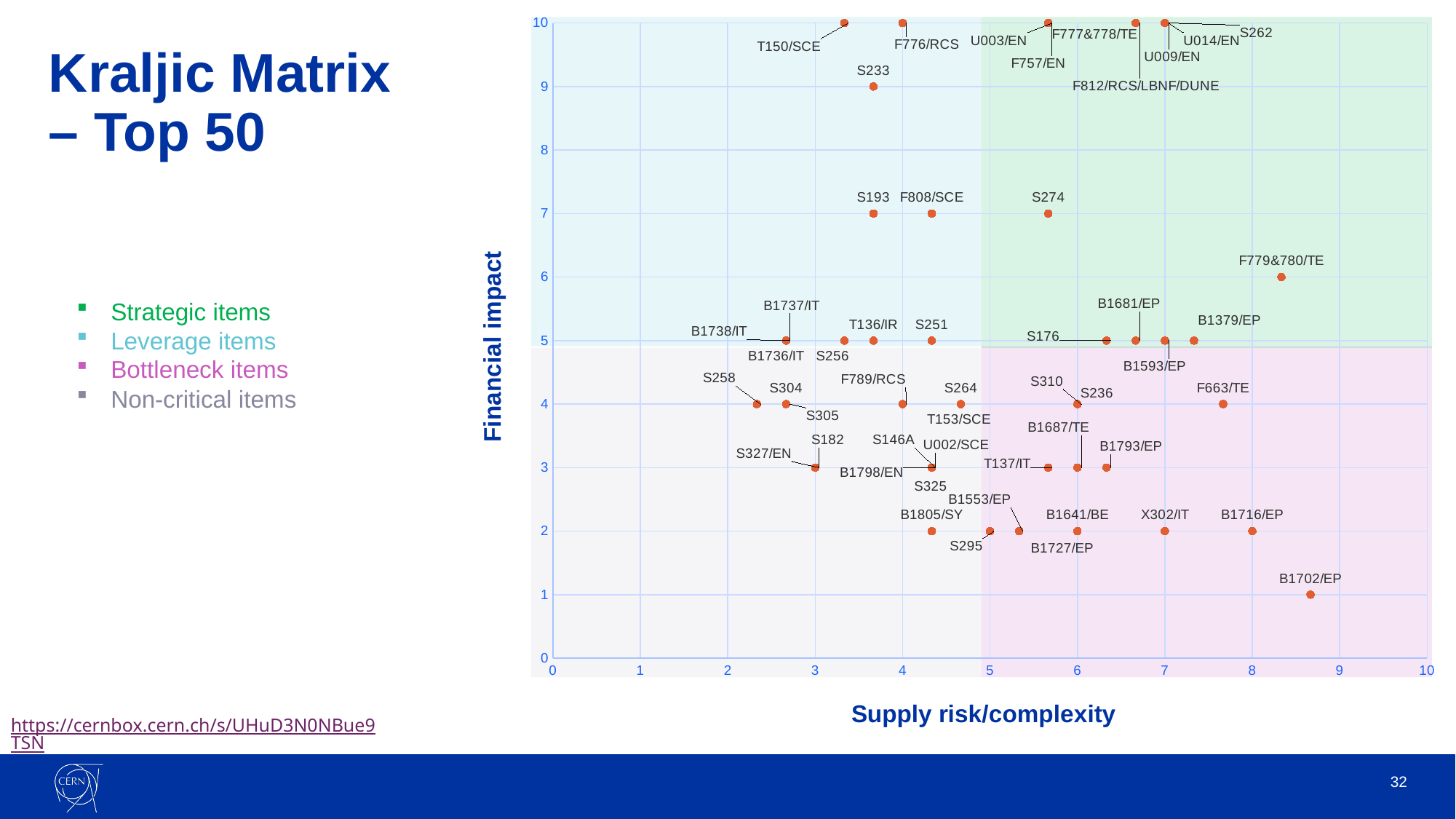
What is the financial impact value for F779&780/TE? 6 What is the supply risk/complexity value for B1716/EP? 8 What is the financial impact value for B1702/EP? 1 What kind of chart is shown on the slide? scatter chart What is the difference in financial impact between S233 and S193? 2 What is the title of the horizontal axis? Supply risk/complexity What is the financial impact value for S233? 9 Is the supply risk/complexity value for S258 greater or less than 3? less Is the supply risk/complexity value for B1702/EP greater or less than 8? greater Which has the higher financial impact, S274 or S264? S274 Which item has the lowest financial impact? B1702/EP What is the supply risk/complexity value for X302/IT? 7